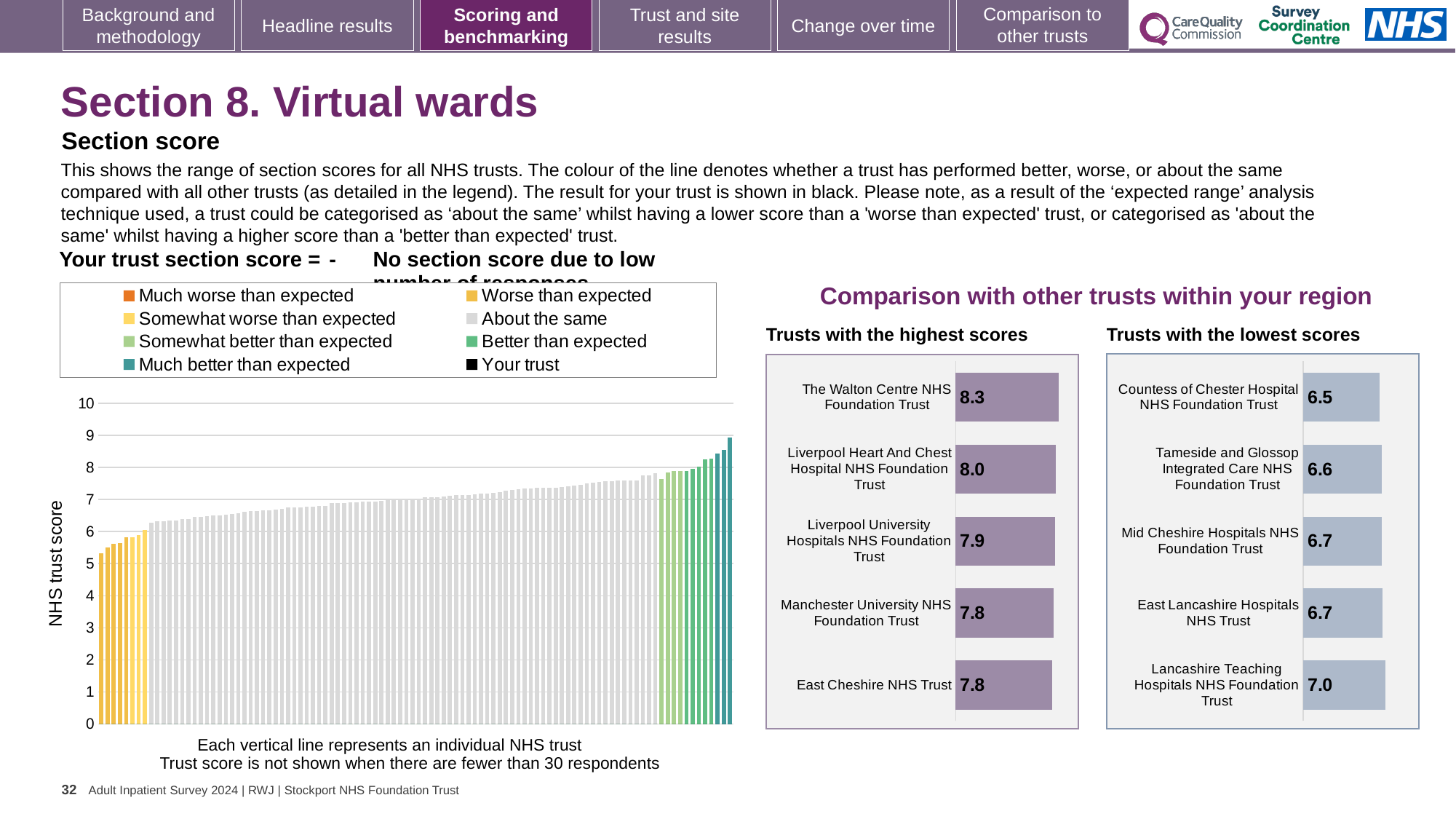
In the 'Trusts with the highest scores' chart, what is the difference between the scores of The Walton Centre NHS Foundation Trust and East Cheshire NHS Trust? 0.5 In the 'Trusts with the highest scores' chart, what is the score for The Walton Centre NHS Foundation Trust? 8.3 What kind of chart is the large chart on the left showing NHS trust scores? Bar chart In the 'Trusts with the lowest scores' chart, what is the score for Lancashire Teaching Hospitals NHS Foundation Trust? 7.0 In the 'Trusts with the highest scores' chart, which trust has the highest score? The Walton Centre NHS Foundation Trust In the 'Trusts with the highest scores' chart, which has the higher score: Liverpool Heart And Chest Hospital NHS Foundation Trust or Liverpool University Hospitals NHS Foundation Trust? Liverpool Heart And Chest Hospital NHS Foundation Trust How many trusts are listed in the 'Trusts with the highest scores' chart? 5 How many entries does the legend above the large chart on the left list? 8 In the 'Trusts with the lowest scores' chart, what is the difference between the scores of Lancashire Teaching Hospitals NHS Foundation Trust and Countess of Chester Hospital NHS Foundation Trust? 0.5 In the 'Trusts with the lowest scores' chart, what is the score for Countess of Chester Hospital NHS Foundation Trust? 6.5 In the 'Trusts with the lowest scores' chart, which trust has the lowest score? Countess of Chester Hospital NHS Foundation Trust In the large chart on the left, do the NHS trust scores rise or fall from left to right? Rise